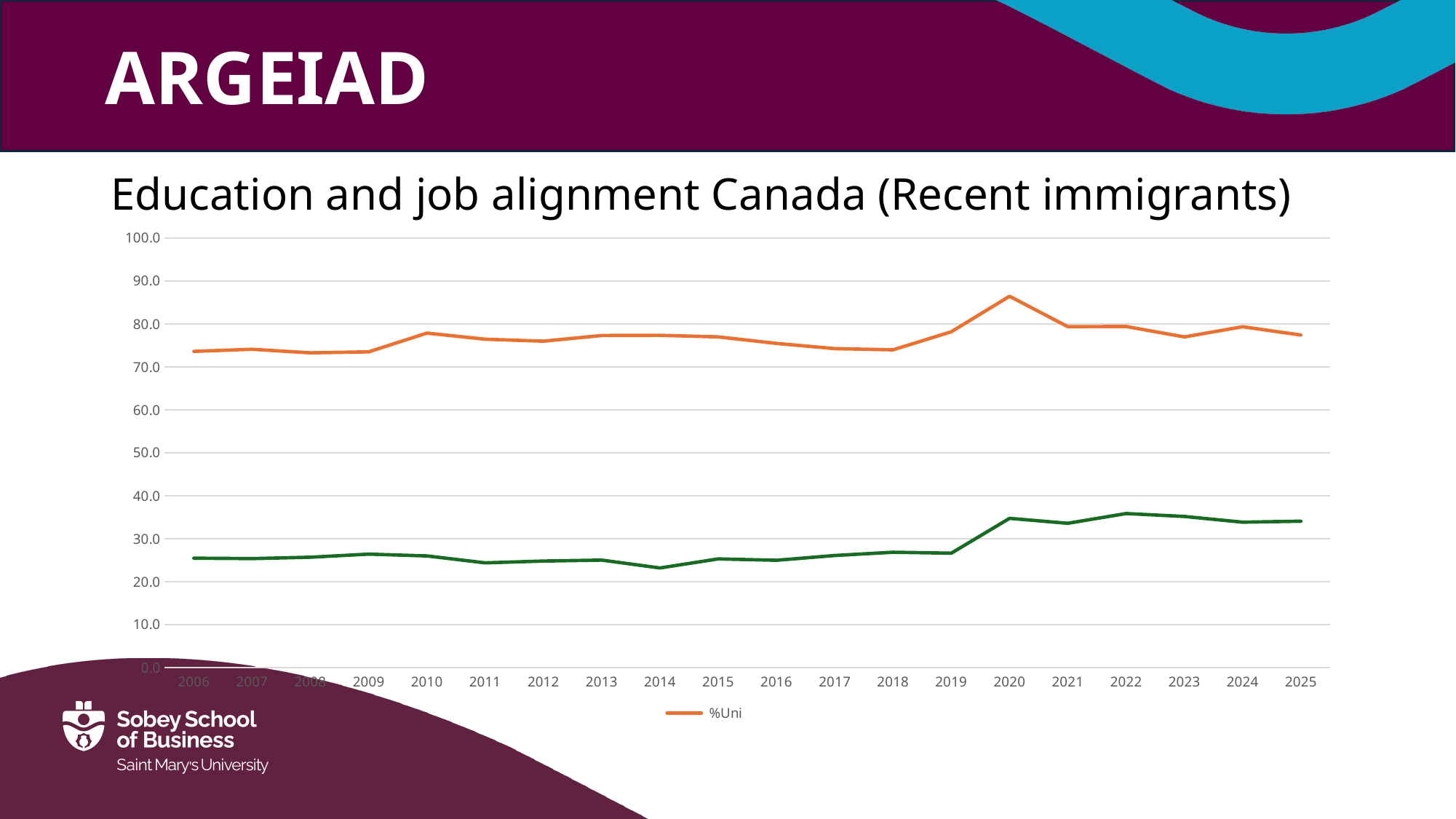
What is the title of the chart? Education and job alignment Canada (Recent immigrants) Is the value of the green line in 2014 greater or less than 30? less What series name appears in the chart legend? %Uni In which year does the %Uni line reach its highest value? 2020 Is the value of the %Uni line in 2020 greater or less than 80? greater Is the value of the green line in 2020 greater or less than 30? greater Which is larger for the %Uni line: the value in 2020 or the value in 2006? 2020 How many years are shown along the x axis of the chart? 20 What kind of chart is shown on the slide? line chart Does the green line rise or fall between 2019 and 2020? rise How many series does the chart legend list? 1